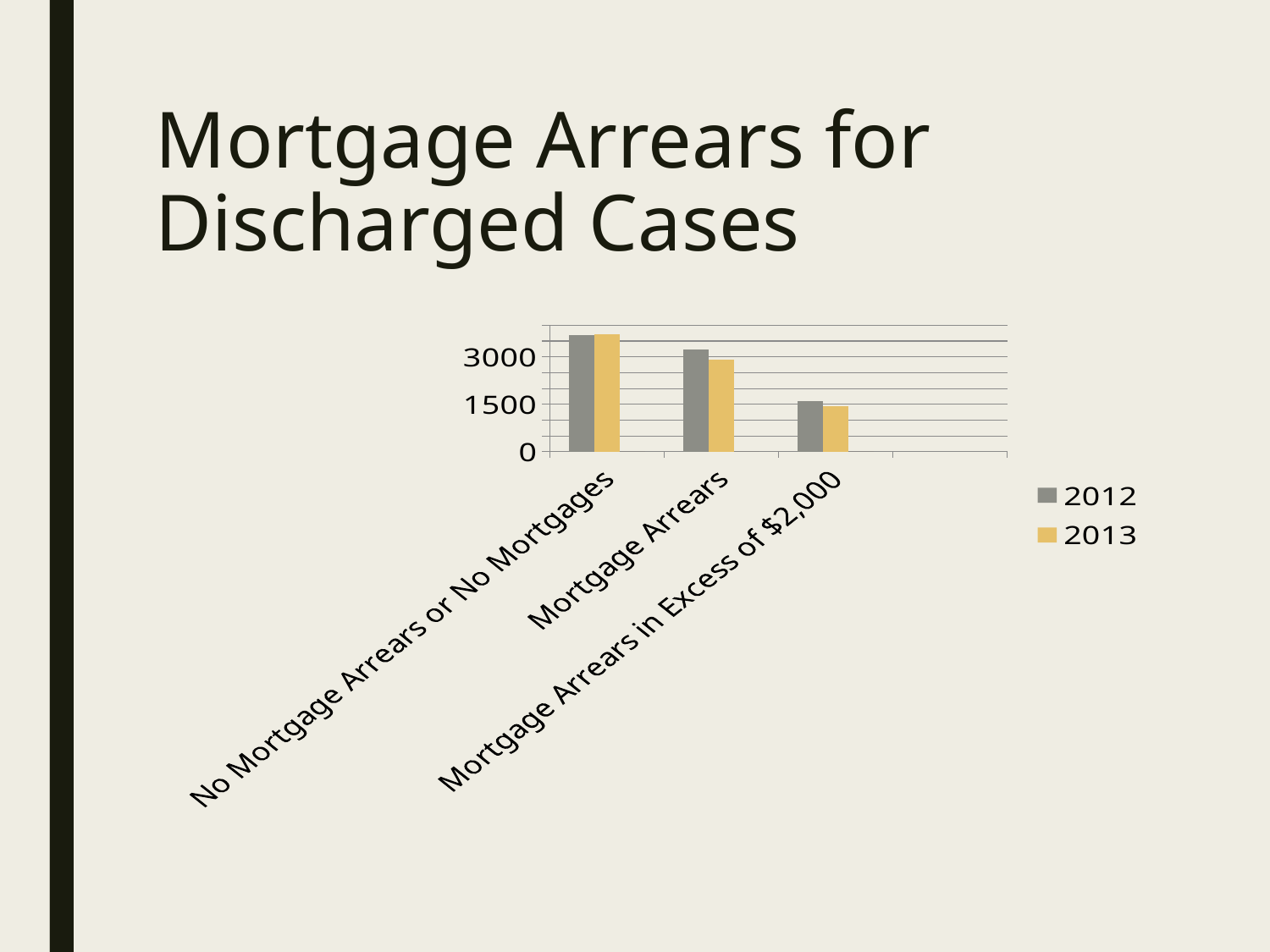
Which series are listed in the chart's legend? 2012 and 2013 For Mortgage Arrears in Excess of $2,000, which is larger: the 2012 value or the 2013 value? 2012 Is the 2013 value for Mortgage Arrears greater or less than 1500? greater What kind of chart is shown on the slide? bar chart Is the 2013 value for No Mortgage Arrears or No Mortgages greater or less than 3000? greater For Mortgage Arrears, which is larger: the 2012 value or the 2013 value? 2012 Do the 2012 values rise or fall moving from left to right across the categories? fall Is the 2012 value for Mortgage Arrears in Excess of $2,000 greater or less than 3000? less How many categories are shown on the x axis of the chart? 3 Which category has the highest value for 2012? No Mortgage Arrears or No Mortgages How many series does the chart's legend list? 2 Which category has the lowest value for 2013? Mortgage Arrears in Excess of $2,000